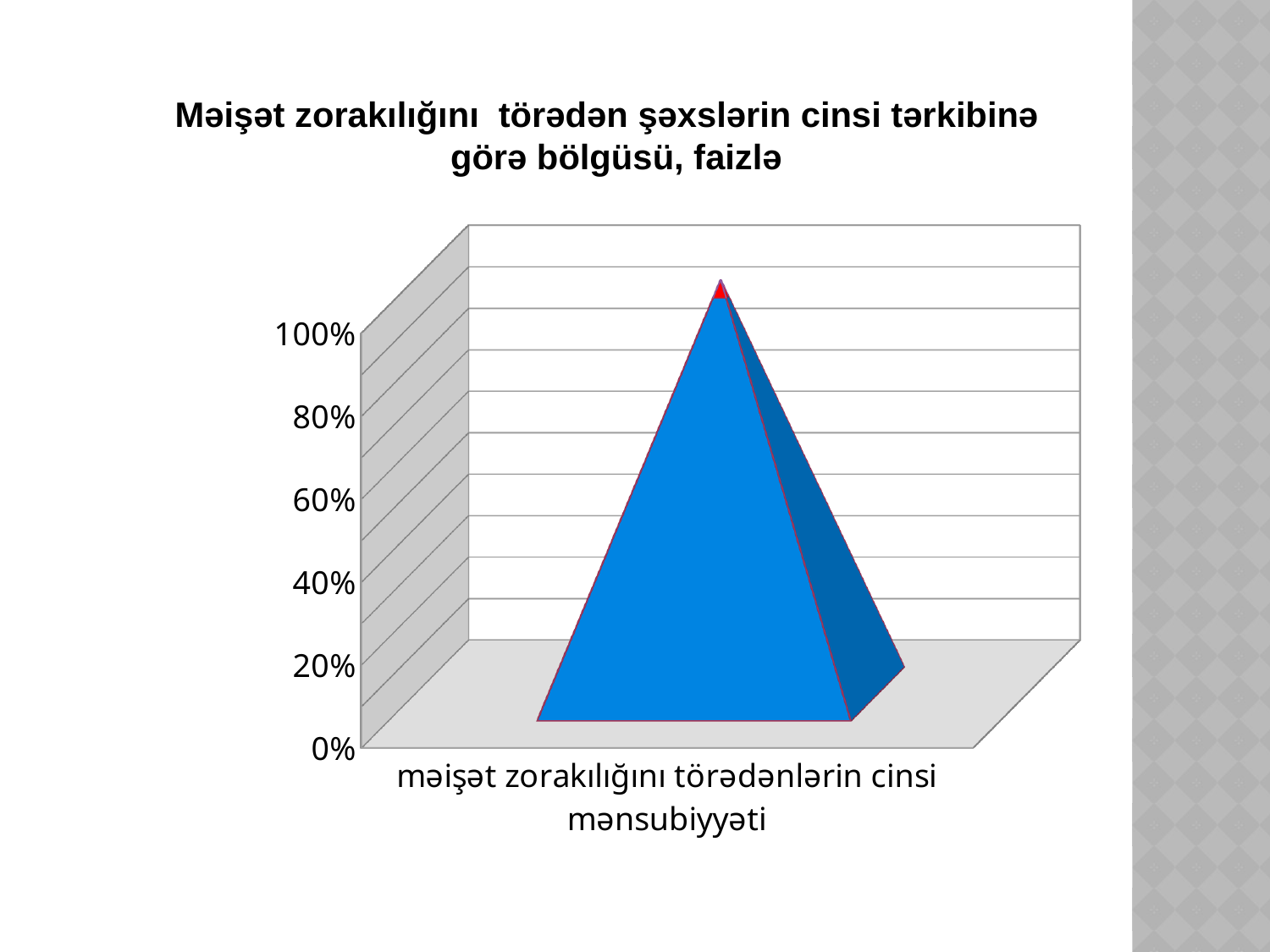
Which segment of the bar is larger, the blue one or the red one? the blue one What is the highest value shown on the vertical axis of the chart? 100% How many categories are shown on the x axis of the chart? 1 What is the category label on the x axis of the chart? məişət zorakılığını törədənlərin cinsi mənsubiyyəti What kind of chart is shown on the slide? bar chart Is the value of the blue segment of the bar greater or less than 80%? greater What is the title of the chart? Məişət zorakılığını törədən şəxslərin cinsi tərkibinə görə bölgüsü, faizlə Is the value of the red segment at the top of the bar greater or less than 20%? less